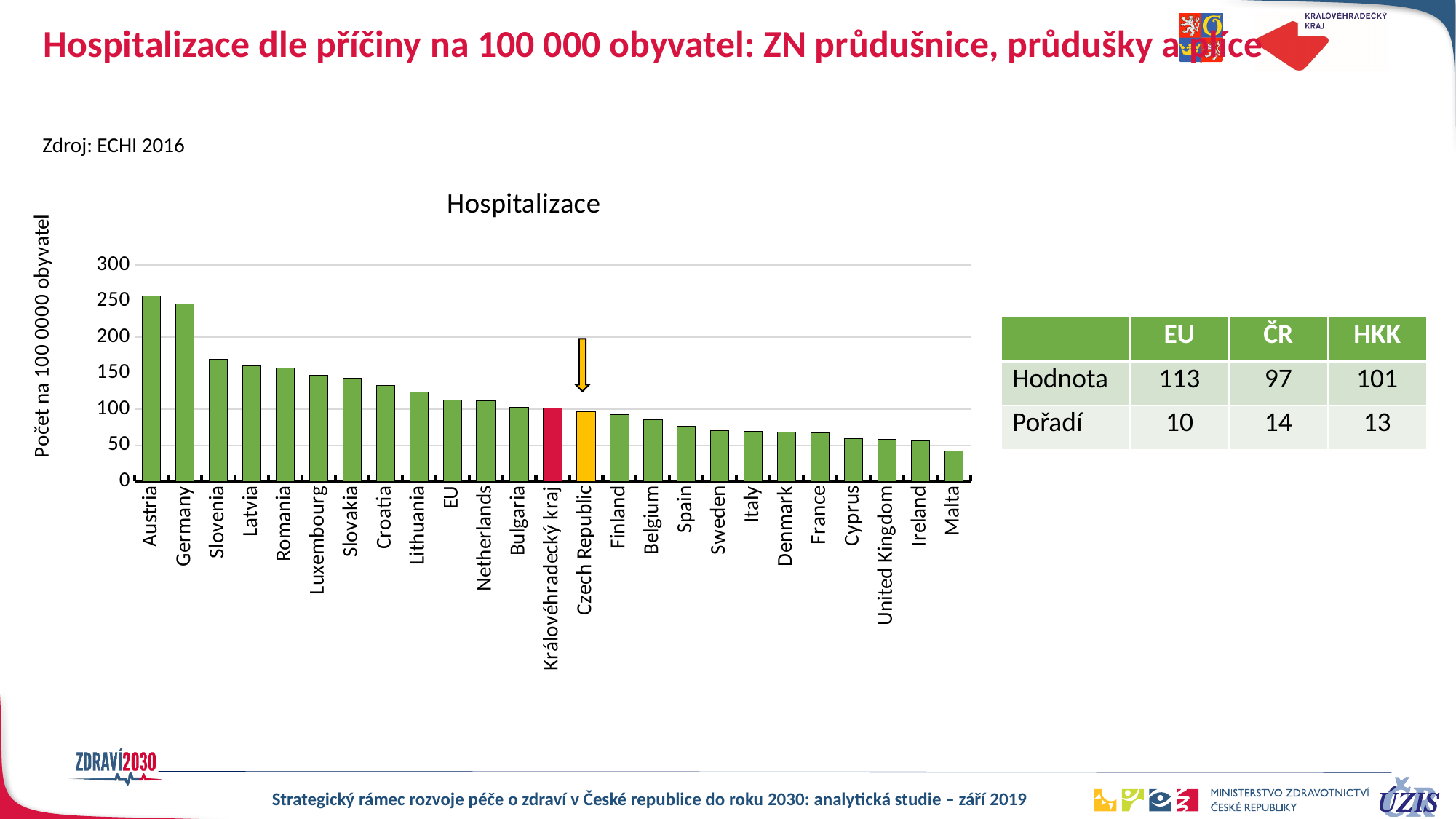
According to the table, what is the value (Hodnota) for EU? 113 Which category has the lowest value in the chart? Malta According to the table, what is the value (Hodnota) for ČR (Czech Republic)? 97 What type of chart is shown on the slide? bar chart Which is larger, the value for Germany or the value for Slovenia? Germany How many categories (bars) are plotted in the chart? 25 What is the difference between the EU value and the ČR value shown in the table? 16 According to the table, what is the value (Hodnota) for HKK (Královéhradecký kraj)? 101 Which category has the highest value in the chart? Austria Do the values rise or fall moving from left to right along the x axis? fall What is the title of the chart? Hospitalizace Is the value for Germany greater or less than 200? greater